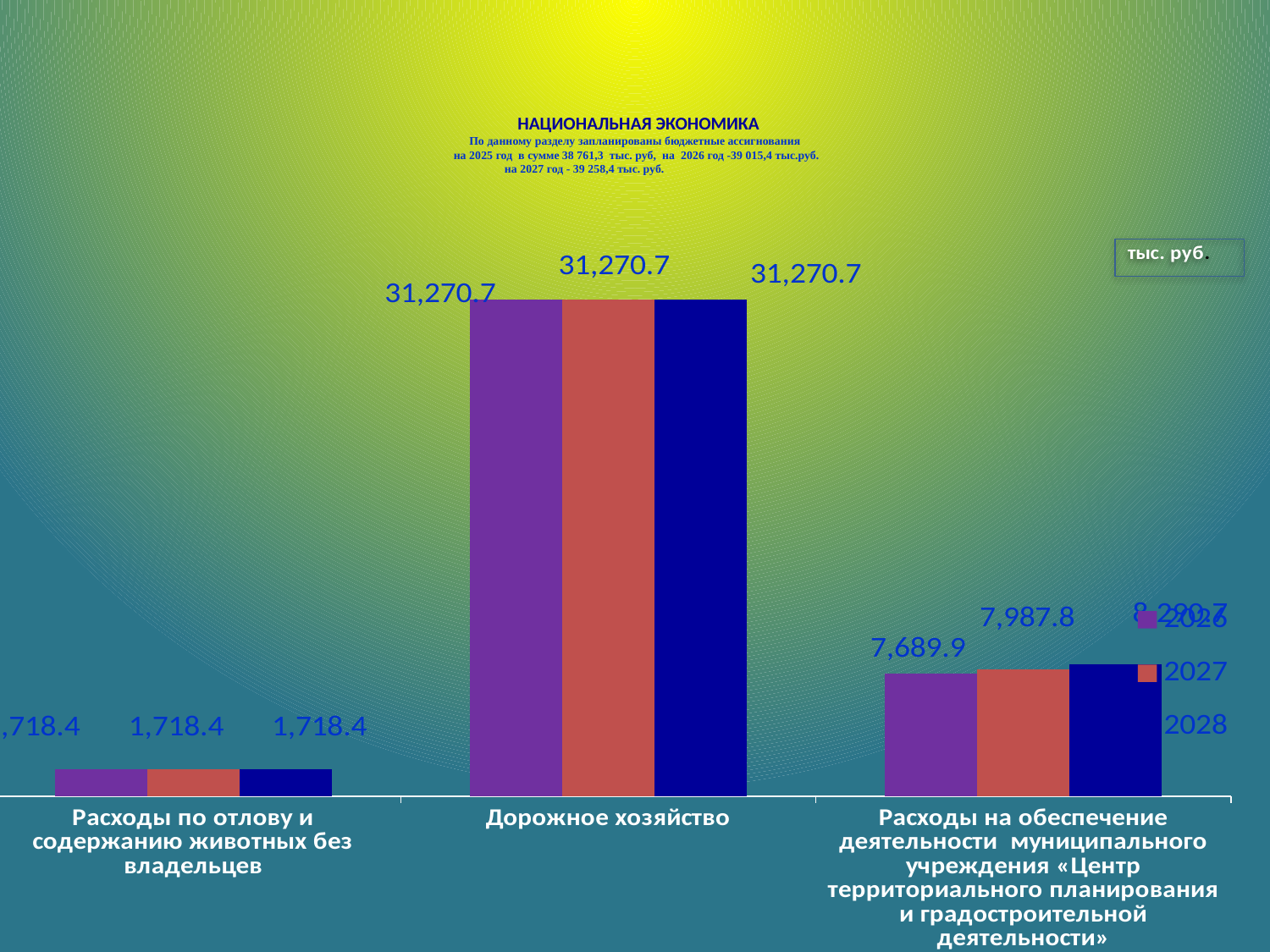
What unit is indicated in the box at the top right of the chart? тыс. руб. What is the value for Расходы по отлову и содержанию животных без владельцев in the 2027 series? 1,718.4 How many series does the chart legend list? 3 Which category has the highest values in the chart? Дорожное хозяйство What is the 2027 value for Расходы на обеспечение деятельности муниципального учреждения «Центр территориального планирования и градостроительной деятельности»? 7,987.8 How many categories are shown on the x axis of the chart? 3 Which category has the lowest values in the chart? Расходы по отлову и содержанию животных без владельцев What is the value for Дорожное хозяйство in the 2026 series? 31,270.7 For the category Расходы на обеспечение деятельности муниципального учреждения «Центр территориального планирования и градостроительной деятельности», which is larger: the 2026 value or the 2027 value? 2027 What kind of chart is shown on the slide? bar chart What is the difference between the 2026 value for Дорожное хозяйство and the 2026 value for Расходы по отлову и содержанию животных без владельцев? 29,552.3 What is the 2026 value for Расходы на обеспечение деятельности муниципального учреждения «Центр территориального планирования и градостроительной деятельности»? 7,689.9